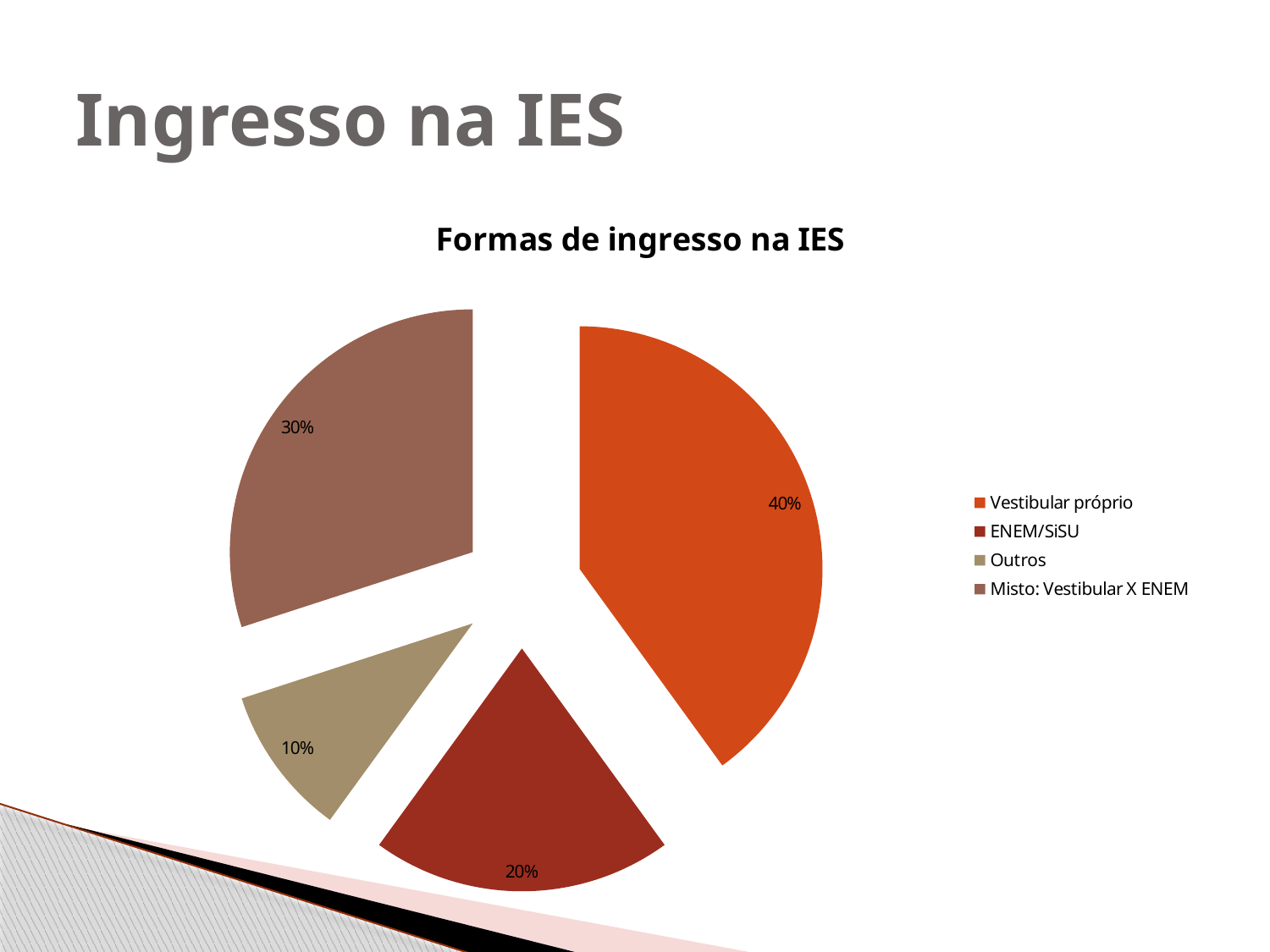
Which is larger, the share for ENEM/SiSU or the share for Outros? ENEM/SiSU What kind of chart is shown on the slide? pie chart Which category has the smallest slice of the pie? Outros How many entries does the legend list? 4 How many categories does the pie chart have? 4 What is the title of the chart? Formas de ingresso na IES What is the difference between the shares of Vestibular próprio and Misto: Vestibular X ENEM? 10% What share of the pie does Vestibular próprio have? 40% What share of the pie does Misto: Vestibular X ENEM have? 30% Which category has the largest slice of the pie? Vestibular próprio What share of the pie does ENEM/SiSU have? 20%